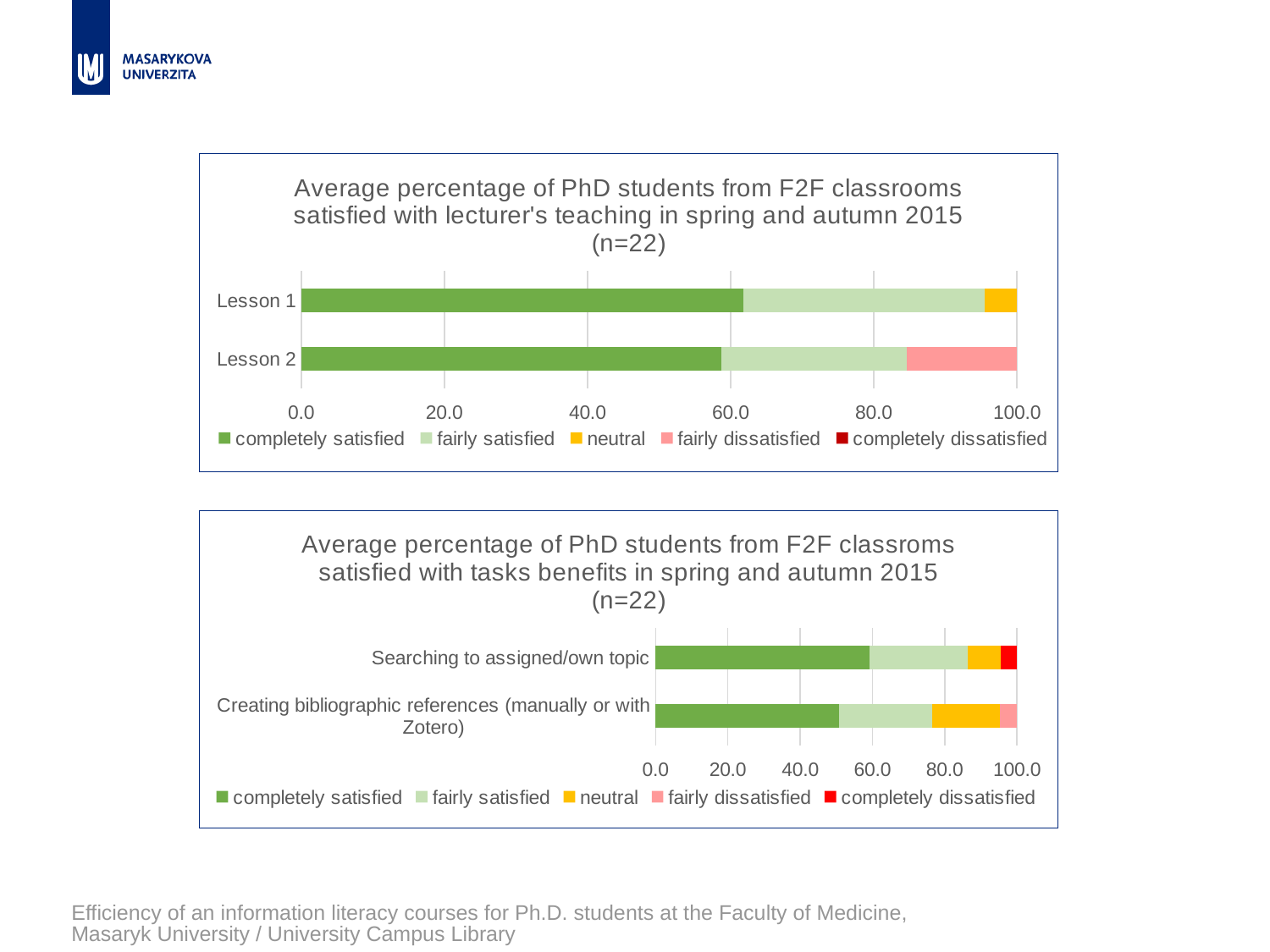
In the top chart (satisfied with lecturer's teaching), which lesson has a 'fairly dissatisfied' segment? Lesson 2 In the top chart (satisfied with lecturer's teaching), is the 'completely satisfied' value for Lesson 2 greater or less than 80.0? less In the bottom chart (satisfied with tasks benefits), how many task categories are shown? 2 In the bottom chart (satisfied with tasks benefits), is the 'completely satisfied' value for 'Creating bibliographic references (manually or with Zotero)' greater or less than 60.0? less In the bottom chart (satisfied with tasks benefits), is the 'completely satisfied' value for 'Searching to assigned/own topic' greater or less than 40.0? greater In the bottom chart (satisfied with tasks benefits), how many series does the legend list? 5 In the top chart (satisfied with lecturer's teaching), how many series does the legend list? 5 What kind of chart is the top chart (satisfied with lecturer's teaching)? Stacked bar chart In the bottom chart (satisfied with tasks benefits), which task has a 'completely dissatisfied' segment? Searching to assigned/own topic In the bottom chart (satisfied with tasks benefits), which task has the larger 'completely satisfied' value: 'Searching to assigned/own topic' or 'Creating bibliographic references (manually or with Zotero)'? Searching to assigned/own topic In the top chart (satisfied with lecturer's teaching), how many lessons are shown on the vertical axis? 2